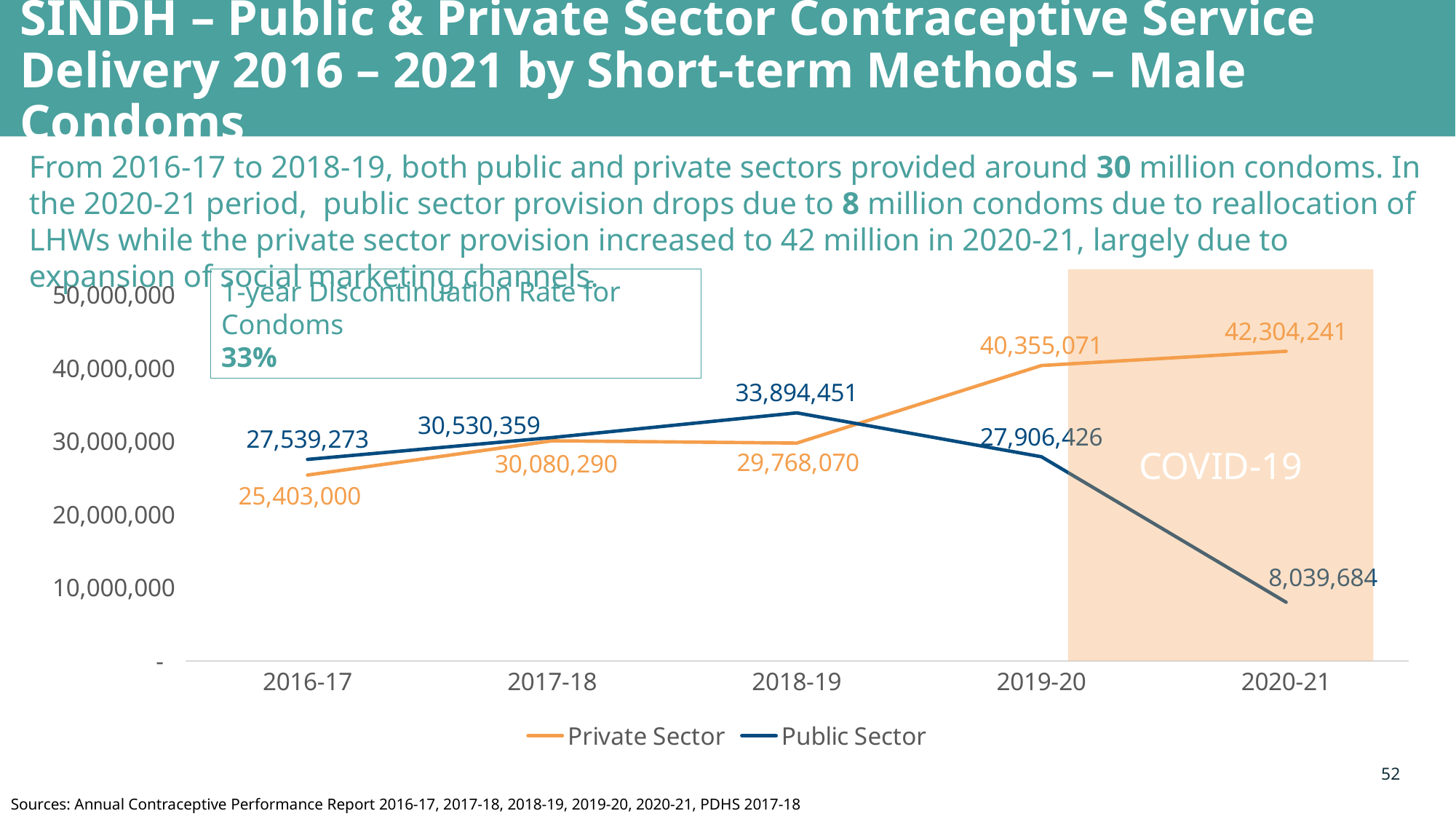
What is the Public Sector value for 2018-19? 33,894,451 What type of chart is shown on the slide? Line chart How many time periods are shown on the x axis? 5 What is the difference between the Private Sector and Public Sector values in 2020-21? 34,264,557 How many series does the legend list? 2 In 2018-19, which series has the larger value, Private Sector or Public Sector? Public Sector Does the Public Sector line rise or fall from 2018-19 to 2020-21? Fall What is the Private Sector value for 2020-21? 42,304,241 What is the Private Sector value for 2016-17? 25,403,000 In which period is the Public Sector value lowest? 2020-21 In which period is the Private Sector value highest? 2020-21 What is the Public Sector value for 2020-21? 8,039,684